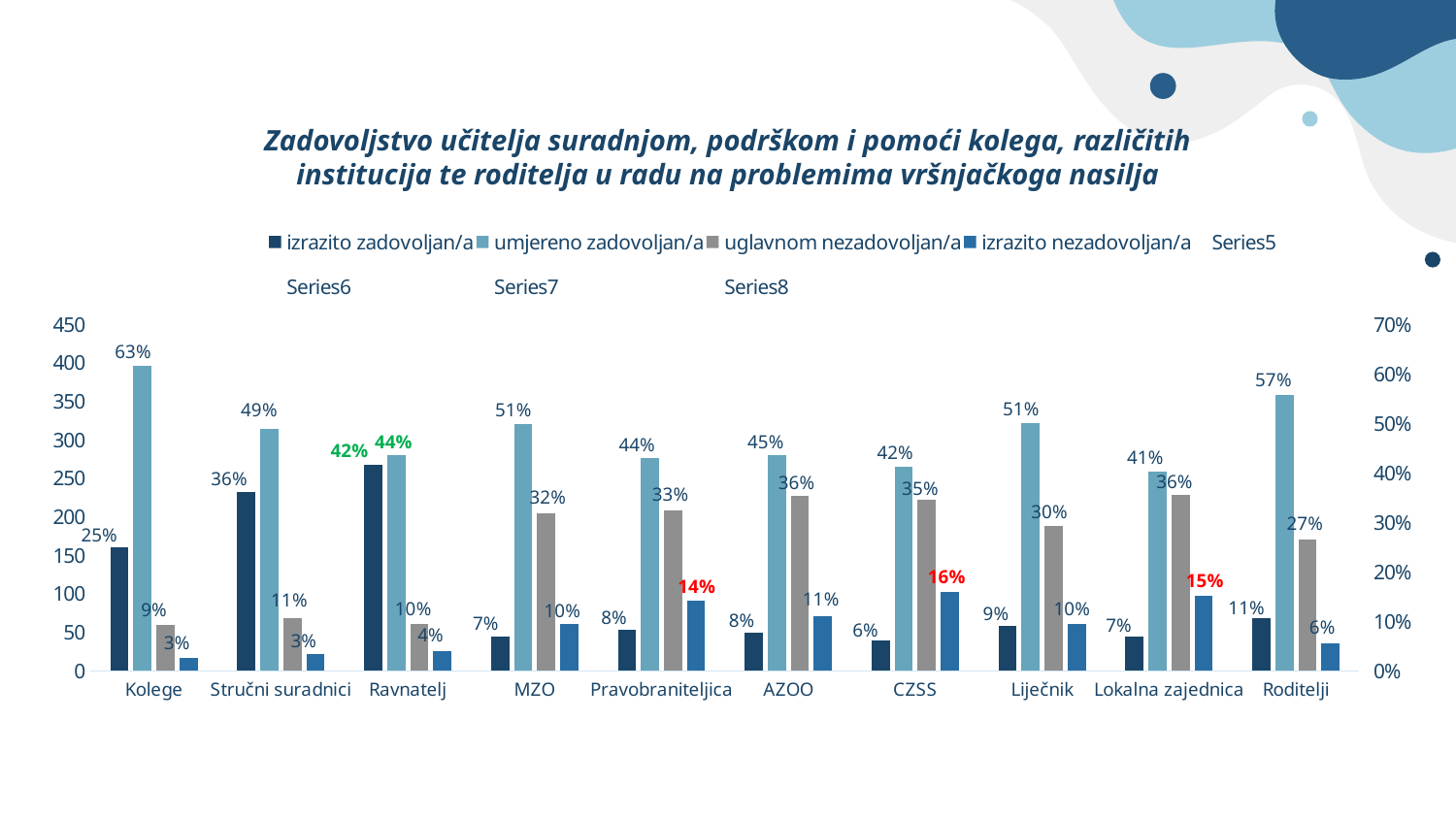
How many categories are shown on the x axis? 10 What is the value of "izrazito nezadovoljan/a" for CZSS? 16% Which legend entry is shown in light blue? umjereno zadovoljan/a Which is larger: the "uglavnom nezadovoljan/a" value for AZOO or for Liječnik? AZOO How many series does the legend list? 8 Which category has the lowest value for "izrazito zadovoljan/a"? CZSS What is the difference between the "umjereno zadovoljan/a" values for Roditelji and Lokalna zajednica? 16% What is the value of "izrazito zadovoljan/a" for Ravnatelj? 42% What kind of chart is shown on the slide? Bar chart Which category has the highest value for "umjereno zadovoljan/a"? Kolege What is the value of "uglavnom nezadovoljan/a" for Roditelji? 27% What is the value of "umjereno zadovoljan/a" for Kolege? 63%